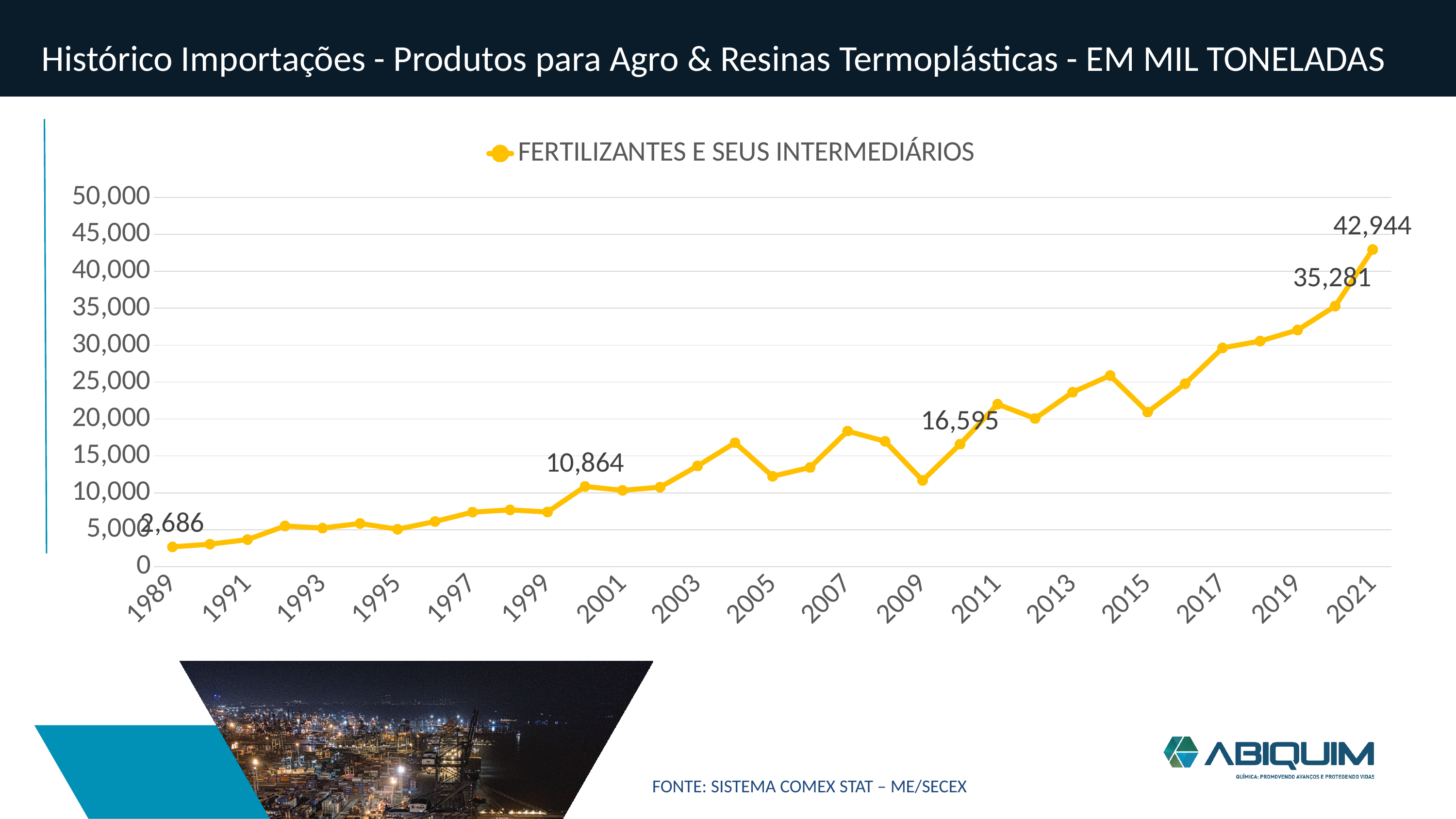
What kind of chart is shown on the slide? line chart Is the value for 2015 greater or less than 25,000? less What is the difference between the values for 2021 and 2020? 7,663 What is the value for 2000? 10,864 What is the value for 2020? 35,281 What is the name of the series shown in the legend? FERTILIZANTES E SEUS INTERMEDIÁRIOS Which is larger, the value for 2011 or the value for 2000? 2011 Which year has the highest value? 2021 Which year has the lowest value? 1989 What is the value for 2021? 42,944 How many series does the legend list? 1